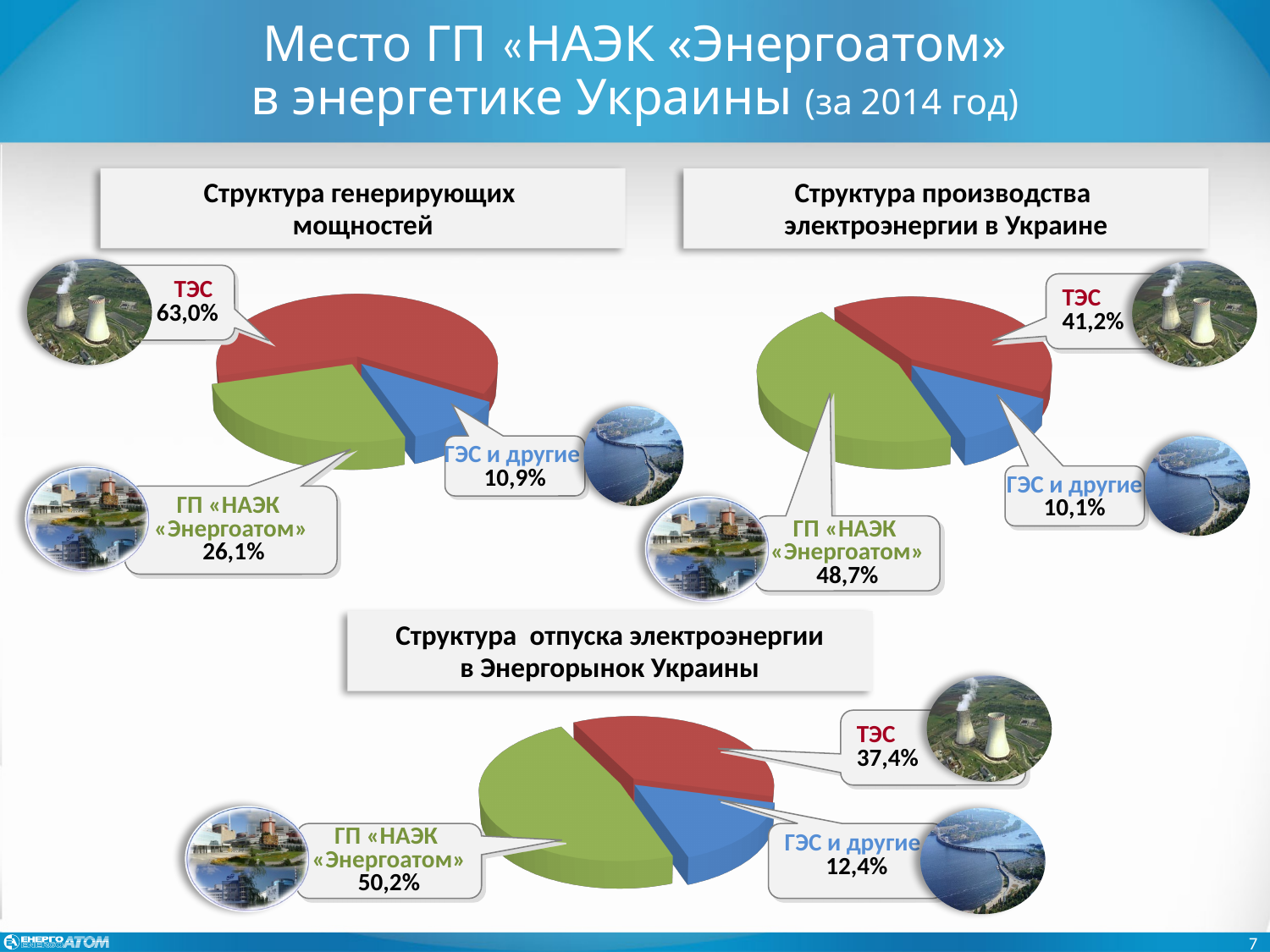
In the chart titled «Структура производства электроэнергии в Украине», what is the share for ГЭС и другие? 10,1% In the chart titled «Структура генерирующих мощностей», which category has the largest share? ТЭС How many slices does the chart titled «Структура отпуска электроэнергии в Энергорынок Украины» have? 3 In the chart titled «Структура отпуска электроэнергии в Энергорынок Украины», which category has the smallest share? ГЭС и другие In the chart titled «Структура производства электроэнергии в Украине», what is the difference between the shares of ГП «НАЭК «Энергоатом» and ТЭС? 7,5% In the chart titled «Структура производства электроэнергии в Украине», which category has the largest share? ГП «НАЭК «Энергоатом» In the chart titled «Структура генерирующих мощностей», what is the share for ТЭС? 63,0% In the chart titled «Структура генерирующих мощностей», which is larger: the share of ГП «НАЭК «Энергоатом» or the share of ГЭС и другие? ГП «НАЭК «Энергоатом» In the chart titled «Структура отпуска электроэнергии в Энергорынок Украины», what is the share for ГП «НАЭК «Энергоатом»? 50,2% In the chart titled «Структура отпуска электроэнергии в Энергорынок Украины», what is the share for ТЭС? 37,4% What kind of chart is used for «Структура генерирующих мощностей»? Pie chart In the chart titled «Структура генерирующих мощностей», what is the share for ГП «НАЭК «Энергоатом»? 26,1%